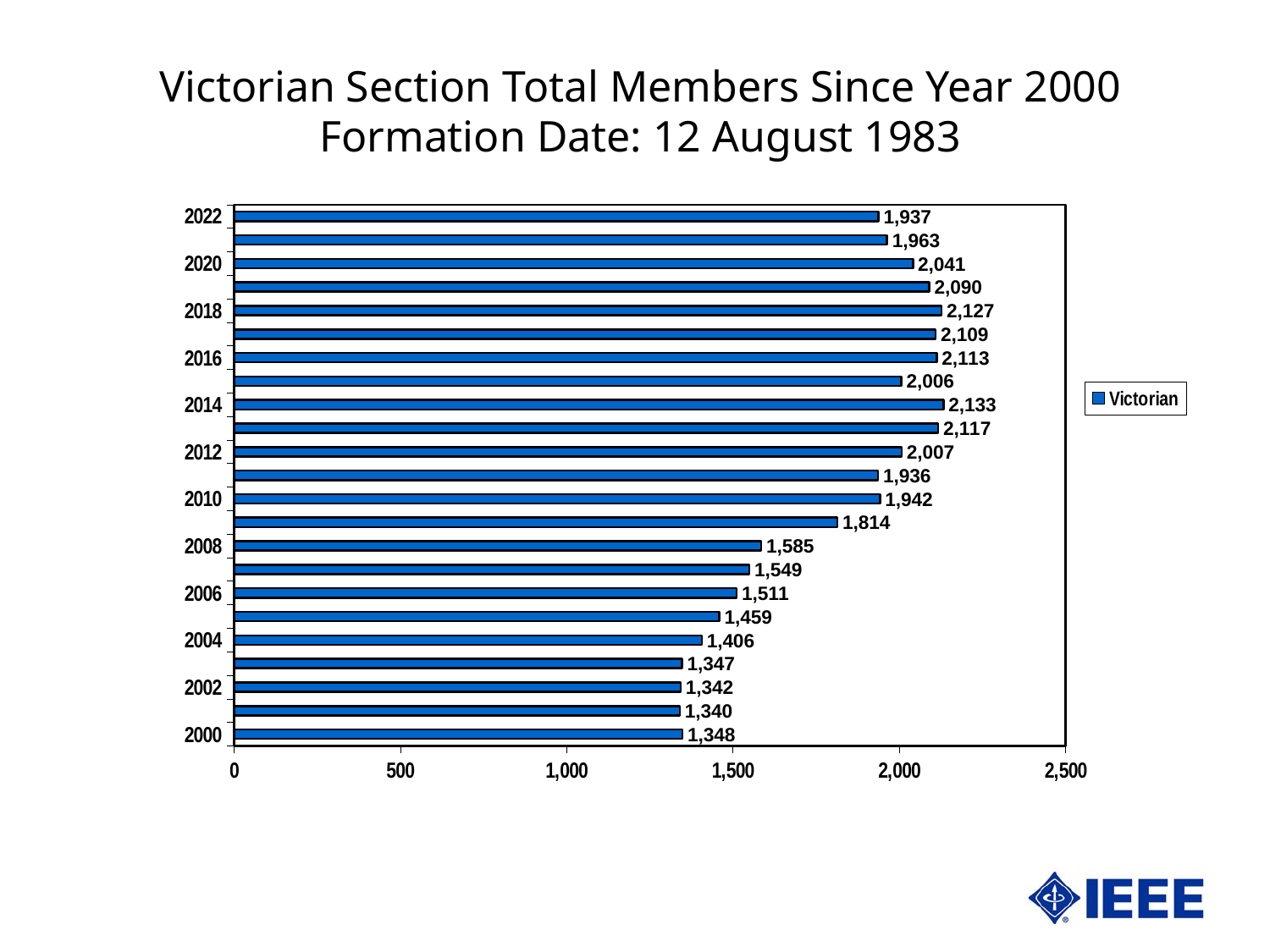
How many series does the legend list? 1 Which is larger, the value for 2010 or the value for 2012? 2012 What is the value for 2022? 1,937 What kind of chart is shown? Bar chart What is the difference between the values for 2022 and 2000? 589 What is the value for 2014? 2,133 What is the difference between the values for 2018 and 2020? 86 Which year has the highest value? 2014 Is the value for 2006 greater or less than 1,500? greater What is the value for 2000? 1,348 How many bars are plotted in the chart? 23 What is the value for 2008? 1,585